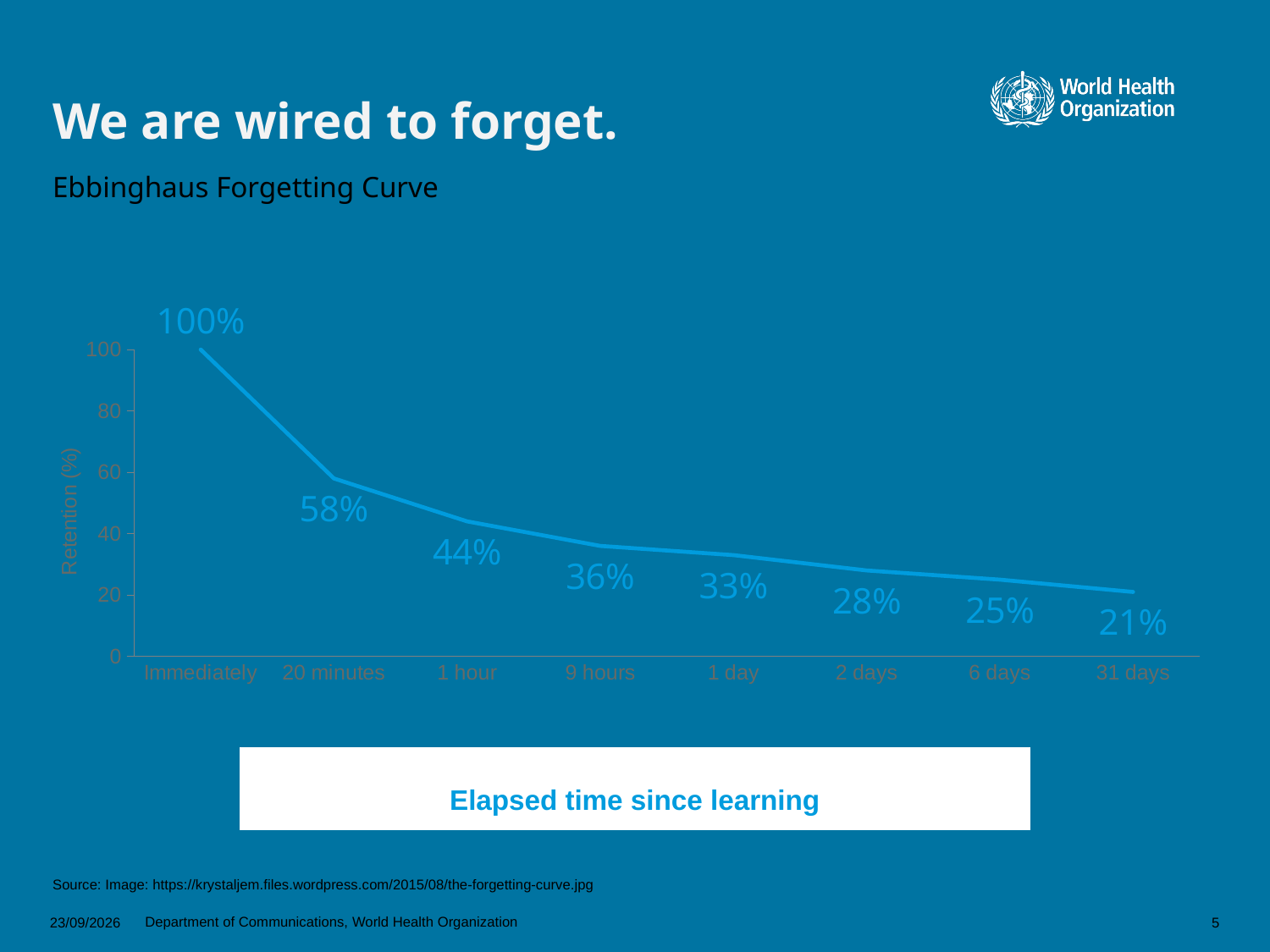
What is the retention value at 1 day? 33% How many time points are plotted on the chart? 8 What is the retention value at 20 minutes? 58% Which has higher retention, 2 days or 1 hour? 1 hour Which time point has the highest retention? Immediately What is the difference in retention between Immediately and 20 minutes? 42% Which time point has the lowest retention? 31 days What is the retention value at 31 days? 21% Do the retention values rise or fall as elapsed time increases? Fall What kind of chart is shown on the slide? Line chart What is the retention value at 9 hours? 36% What is the difference in retention between 1 hour and 6 days? 19%